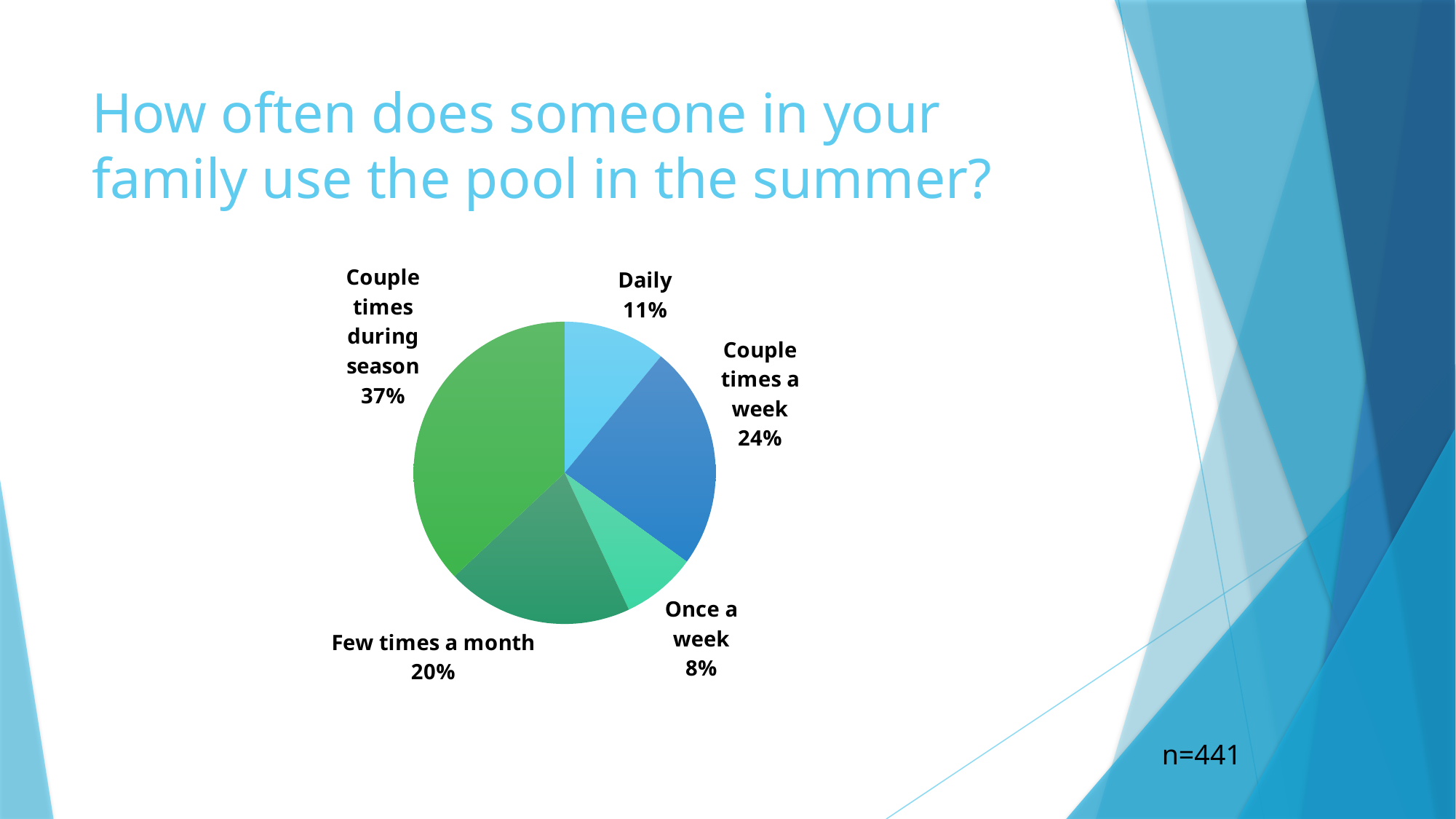
What percentage of respondents use the pool a couple times during the season? 37% How many categories are shown in the pie chart? 5 What percentage of respondents use the pool a few times a month? 20% What kind of chart is shown on the slide? pie chart What percentage of respondents use the pool once a week? 8% What sample size (n) is stated on the slide? n=441 Which category has the largest slice of the pie? Couple times during season Which category has the smallest slice of the pie? Once a week What share of respondents use the pool daily? 11% Which is larger: the share for 'Couple times a week' or the share for 'Daily'? Couple times a week What is the difference in percentage points between 'Couple times during season' and 'Few times a month'? 17 What percentage of respondents use the pool a couple times a week? 24%